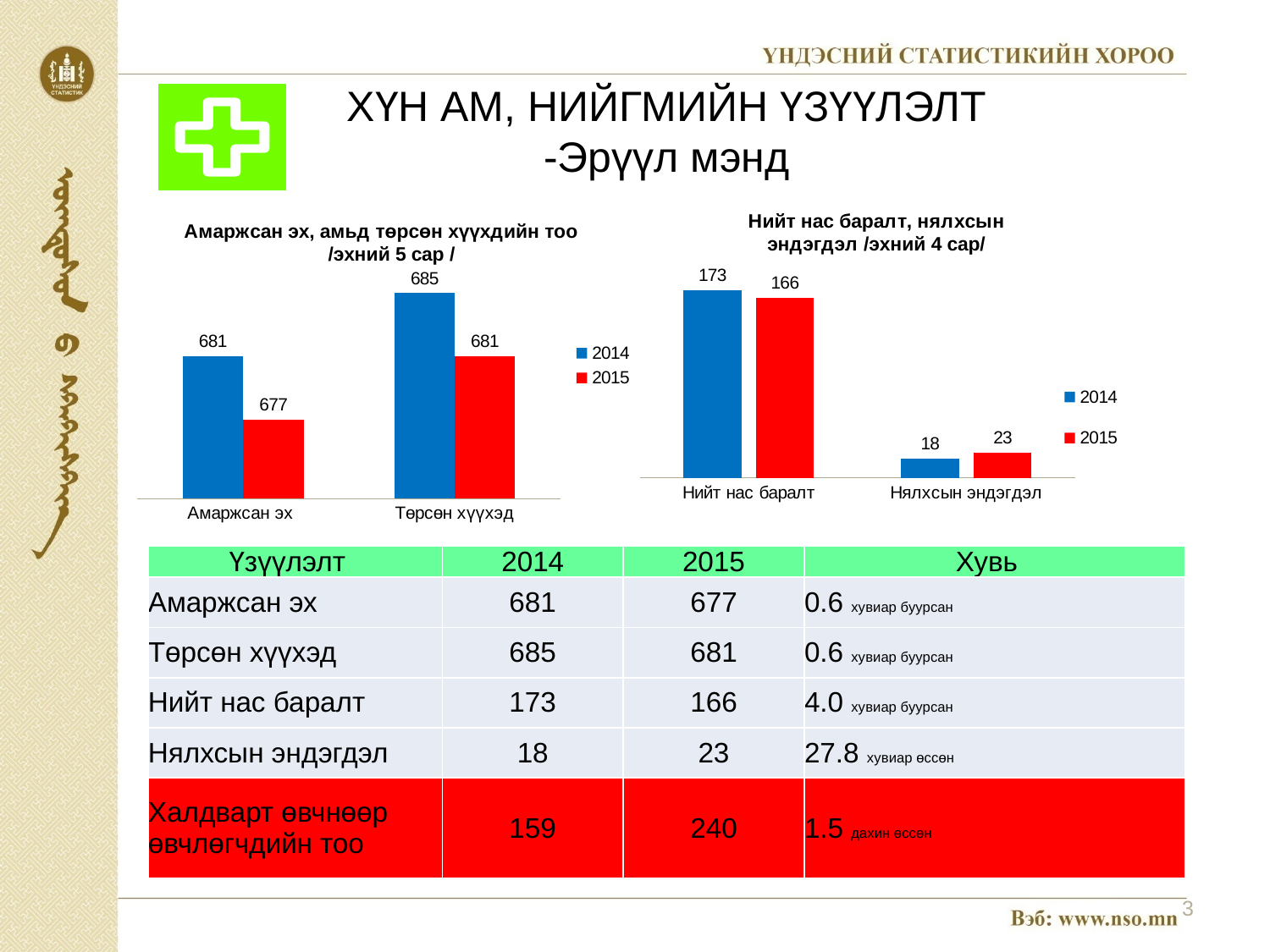
In the left chart, what is the 2014 value for Амаржсан эх? 681 In the left chart, what is the 2015 value for Төрсөн хүүхэд? 681 In the right chart, what is the 2014 value for Нялхсын эндэгдэл? 18 In the right chart, which year has the larger value for Нялхсын эндэгдэл, 2014 or 2015? 2015 In the right chart, which bar is the lowest? Нялхсын эндэгдэл, 2014 How many series does the legend of the right chart list? 2 How many categories are shown on the x axis of the left chart? 2 In the left chart, what is the difference between the 2014 and 2015 values for Амаржсан эх? 4 In the right chart, what is the difference between the 2014 and 2015 values for Нийт нас баралт? 7 What type of chart is the right chart? Bar chart In the right chart, what is the 2015 value for Нийт нас баралт? 166 In the left chart, which bar is the highest? Төрсөн хүүхэд, 2014